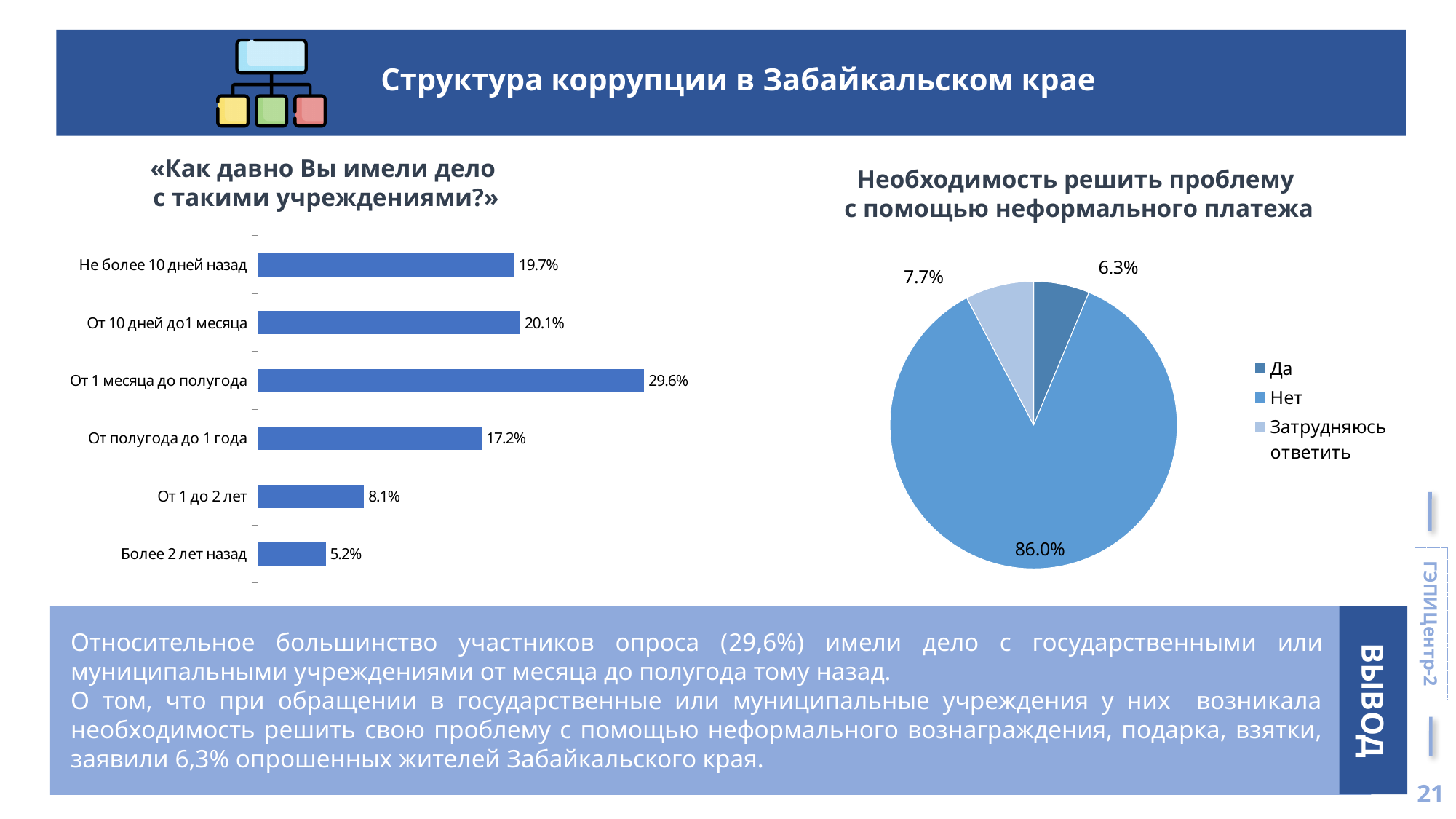
What kind of chart is the chart on the left of the slide? bar chart In the bar chart «Как давно Вы имели дело с такими учреждениями?», what is the value for «От 1 месяца до полугода»? 29.6% In the bar chart «Как давно Вы имели дело с такими учреждениями?», which category has the lowest value? Более 2 лет назад In the bar chart «Как давно Вы имели дело с такими учреждениями?», which category has the highest value? От 1 месяца до полугода In the bar chart «Как давно Вы имели дело с такими учреждениями?», what is the value for «Более 2 лет назад»? 5.2% In the pie chart «Необходимость решить проблему с помощью неформального платежа», what is the share for «Нет»? 86.0% In the bar chart «Как давно Вы имели дело с такими учреждениями?», what is the difference between «От 10 дней до1 месяца» and «От 1 до 2 лет»? 12.0% In the pie chart «Необходимость решить проблему с помощью неформального платежа», which slice is the smallest? Да In the pie chart «Необходимость решить проблему с помощью неформального платежа», what is the share for «Да»? 6.3% In the bar chart «Как давно Вы имели дело с такими учреждениями?», which is larger: «Не более 10 дней назад» or «От полугода до 1 года»? Не более 10 дней назад How many categories does the bar chart «Как давно Вы имели дело с такими учреждениями?» show? 6 How many entries does the legend of the pie chart «Необходимость решить проблему с помощью неформального платежа» list? 3